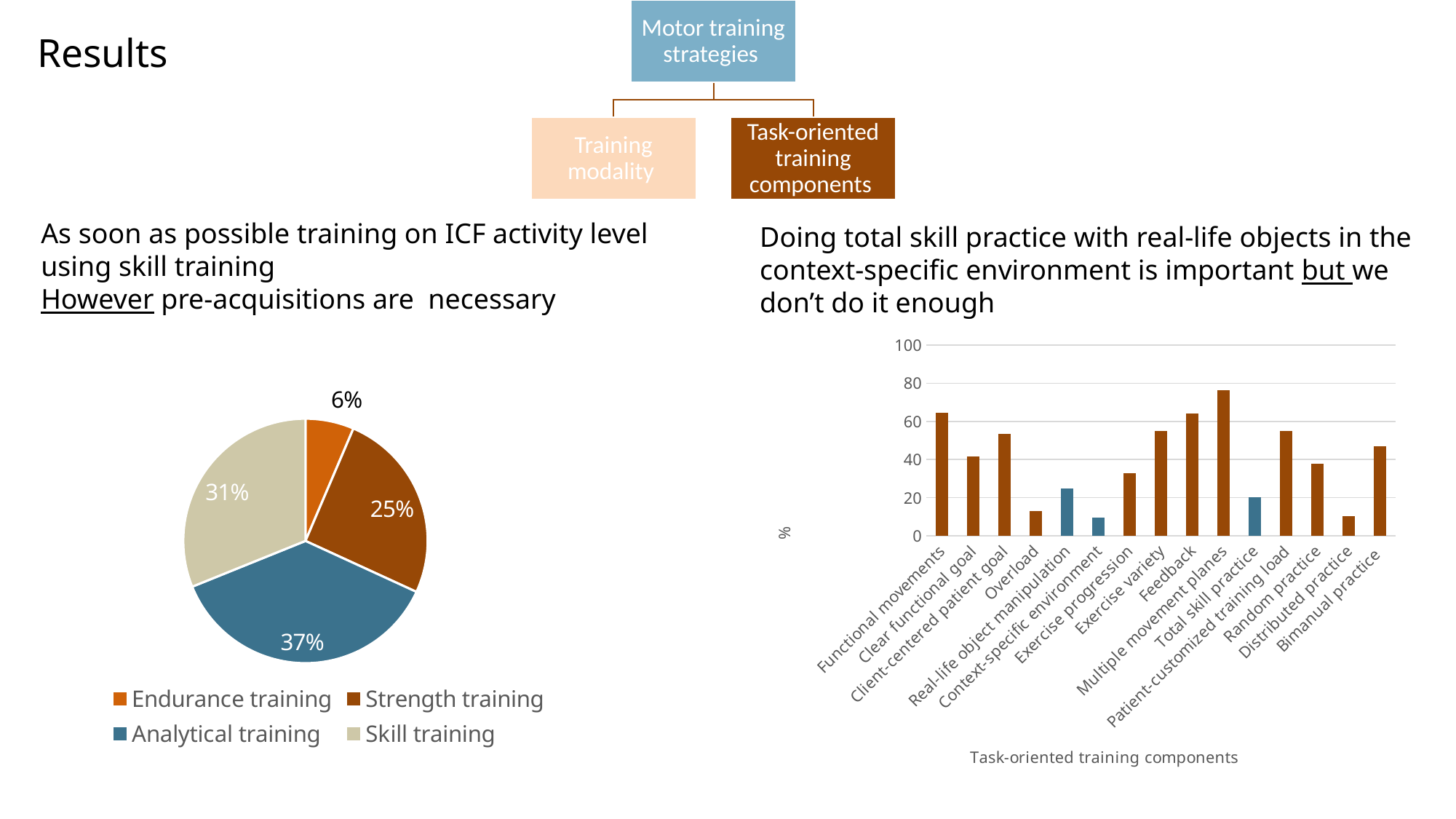
In the bar chart on the right, which is larger: Feedback or Random practice? Feedback In the bar chart on the right, how many task-oriented training components are shown on the x axis? 15 In the pie chart on the left, what is the difference in percentage points between Skill training and Strength training? 6 In the bar chart on the right, which task-oriented training component has the tallest bar? Multiple movement planes In the pie chart on the left, what percentage is Strength training? 25% In the pie chart on the left, how many training modalities are listed in the legend? 4 In the bar chart on the right, is the value for Functional movements greater or less than 60? greater What kind of chart is shown on the right side of the slide? Bar chart In the pie chart on the left, what percentage is Analytical training? 37% In the pie chart on the left, which training modality has the largest share? Analytical training In the bar chart on the right, is the value for Overload greater or less than 20? less In the pie chart on the left, which training modality has the smallest share? Endurance training